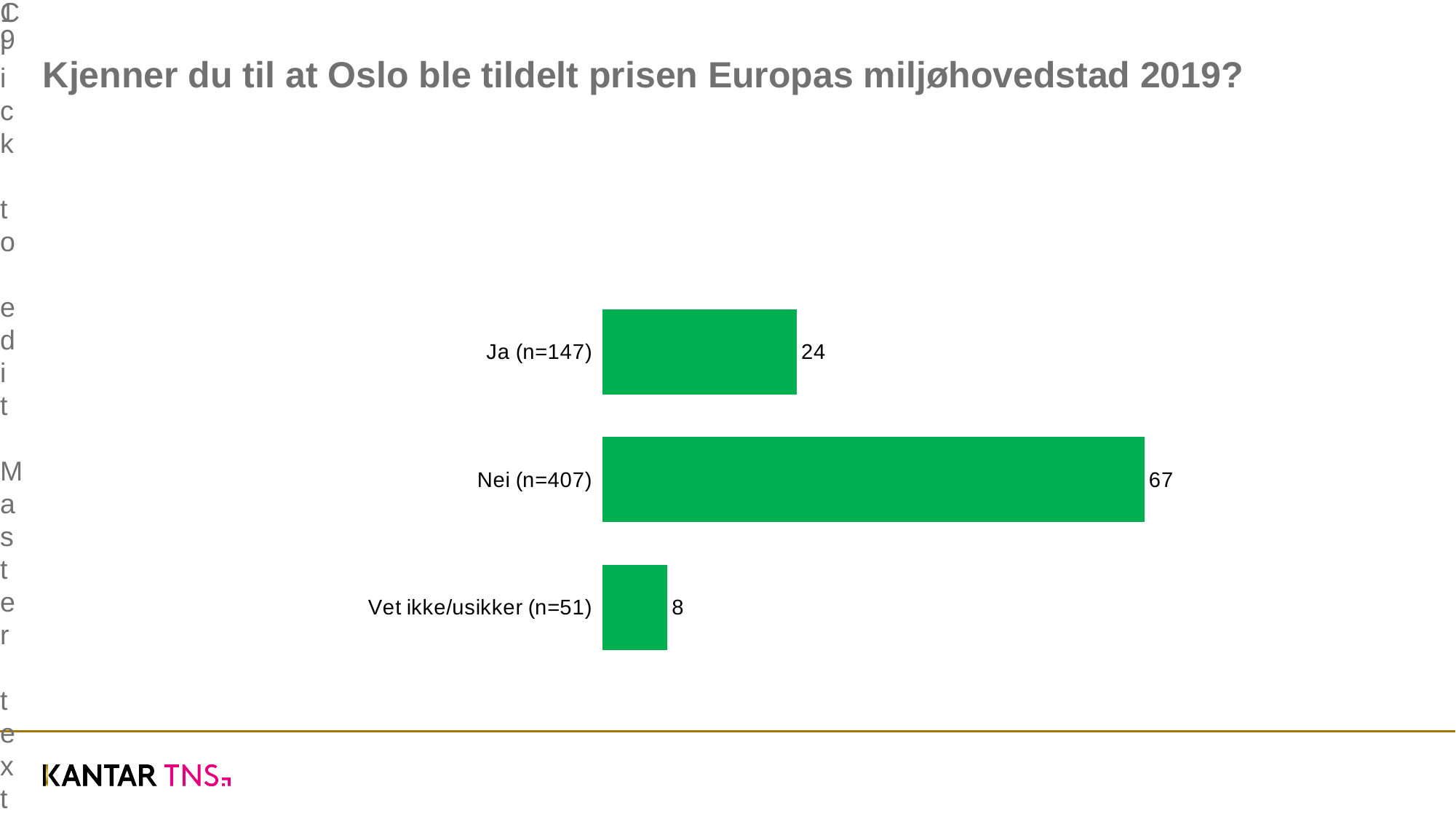
What is the difference between the values for Nei (n=407) and Ja (n=147)? 43 Which category has the lowest value? Vet ikke/usikker (n=51) What is the difference between the values for Ja (n=147) and Vet ikke/usikker (n=51)? 16 What kind of chart is shown on the slide? Bar chart What is the value for Ja (n=147)? 24 Which is larger, the value for Ja (n=147) or the value for Vet ikke/usikker (n=51)? Ja (n=147) What is the value for Nei (n=407)? 67 What colour are the bars in the chart? Green Which category has the highest value? Nei (n=407) What is the title of the slide? Kjenner du til at Oslo ble tildelt prisen Europas miljøhovedstad 2019? What is the value for Vet ikke/usikker (n=51)? 8 How many categories are shown in the chart? 3